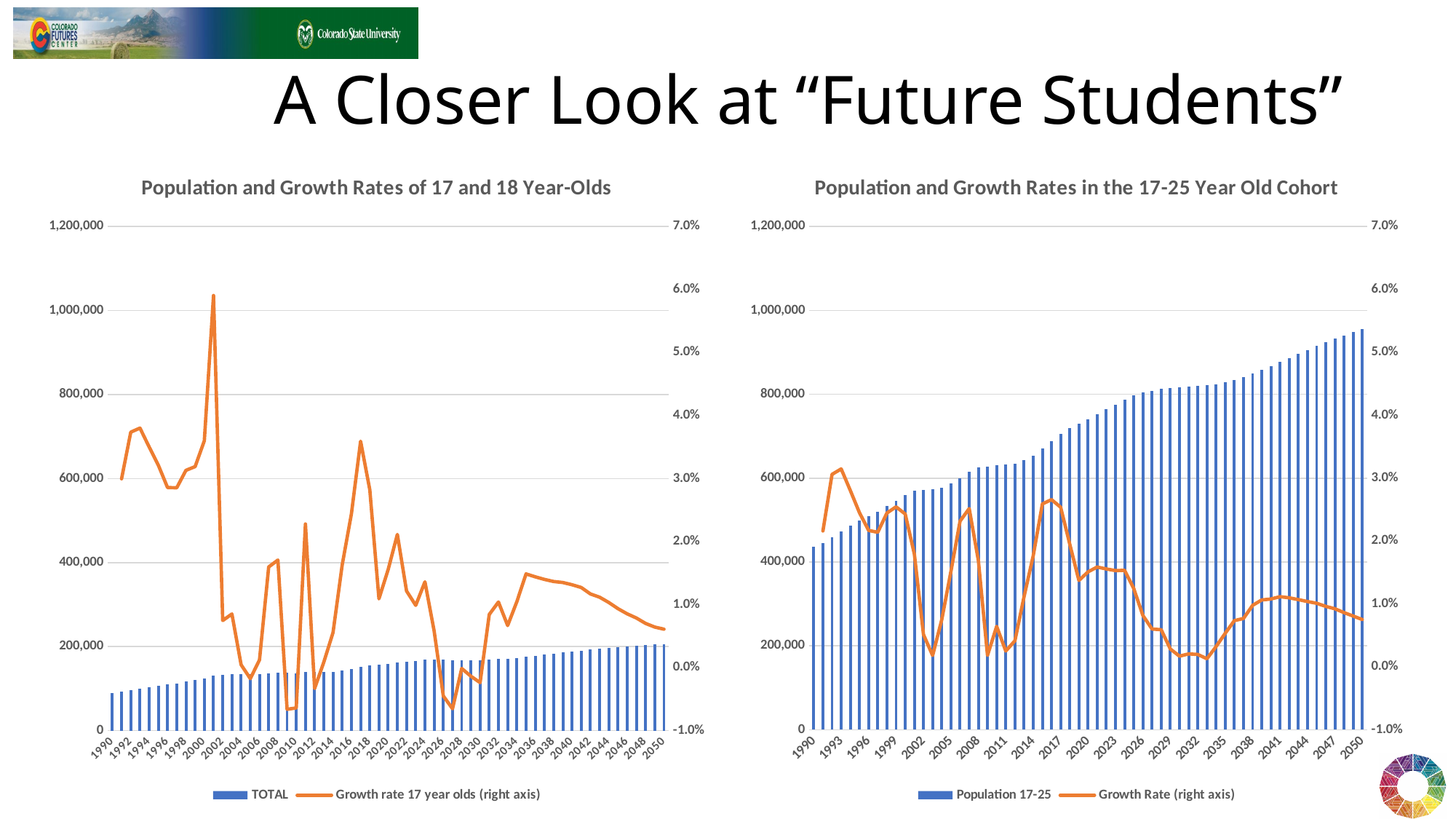
In the left chart, 'Population and Growth Rates of 17 and 18 Year-Olds', is the growth rate in 2002 greater or less than 5.0%? less In the right chart, 'Population and Growth Rates in the 17-25 Year Old Cohort', is the Population 17-25 value for 1990 greater or less than 600,000? less In the right chart, 'Population and Growth Rates in the 17-25 Year Old Cohort', is the Population 17-25 value for 2050 greater or less than 800,000? greater In the right chart, 'Population and Growth Rates in the 17-25 Year Old Cohort', is the Population 17-25 value for 2050 larger or smaller than the value for 1990? larger How many series does the legend of the right chart, 'Population and Growth Rates in the 17-25 Year Old Cohort', list? 2 What kind of chart is the left chart, 'Population and Growth Rates of 17 and 18 Year-Olds'? A combined bar and line chart What is the title of the right chart on the slide? Population and Growth Rates in the 17-25 Year Old Cohort In the right chart, 'Population and Growth Rates in the 17-25 Year Old Cohort', do the Population 17-25 bars rise or fall from 1990 to 2050? Rise In the left chart, 'Population and Growth Rates of 17 and 18 Year-Olds', do the TOTAL bars rise or fall from 1990 to 2050? Rise In the left chart, 'Population and Growth Rates of 17 and 18 Year-Olds', in which year does the growth rate line reach its highest point? 2001 What is the name of the line series in the legend of the left chart, 'Population and Growth Rates of 17 and 18 Year-Olds'? Growth rate 17 year olds (right axis)